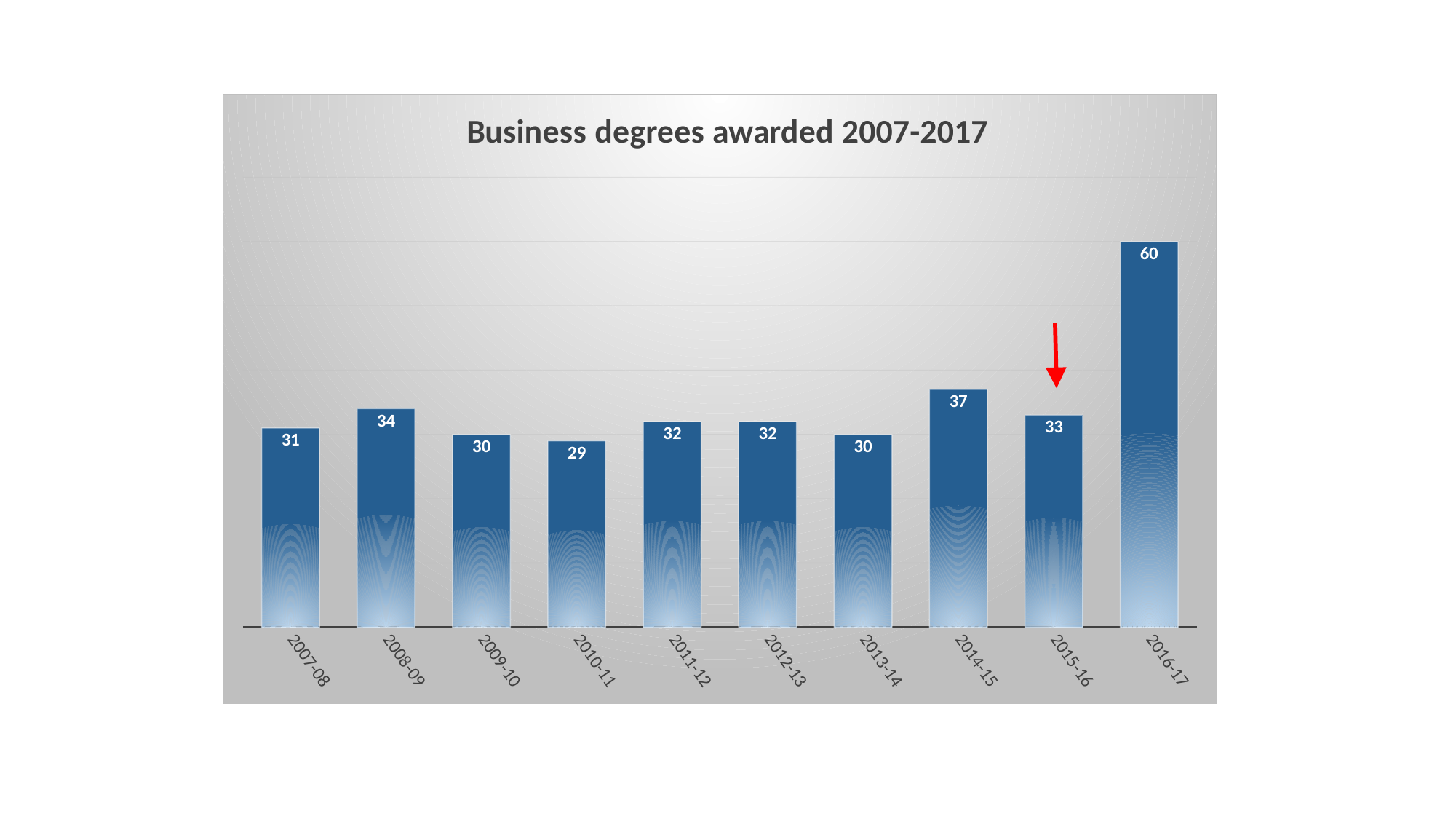
What is the difference between the values for 2016-17 and 2015-16? 27 What is the difference between the values for 2014-15 and 2013-14? 7 Which bar does the red arrow point to? 2015-16 Which is larger, the value for 2008-09 or the value for 2009-10? 2008-09 How many business degrees were awarded in 2016-17? 60 What type of chart is shown on the slide? bar chart What is the value for 2014-15? 37 How many business degrees were awarded in 2010-11? 29 How many years (categories) are shown on the x axis? 10 What is the title of the chart? Business degrees awarded 2007-2017 Which year has the highest number of business degrees awarded? 2016-17 Which year has the lowest number of business degrees awarded? 2010-11